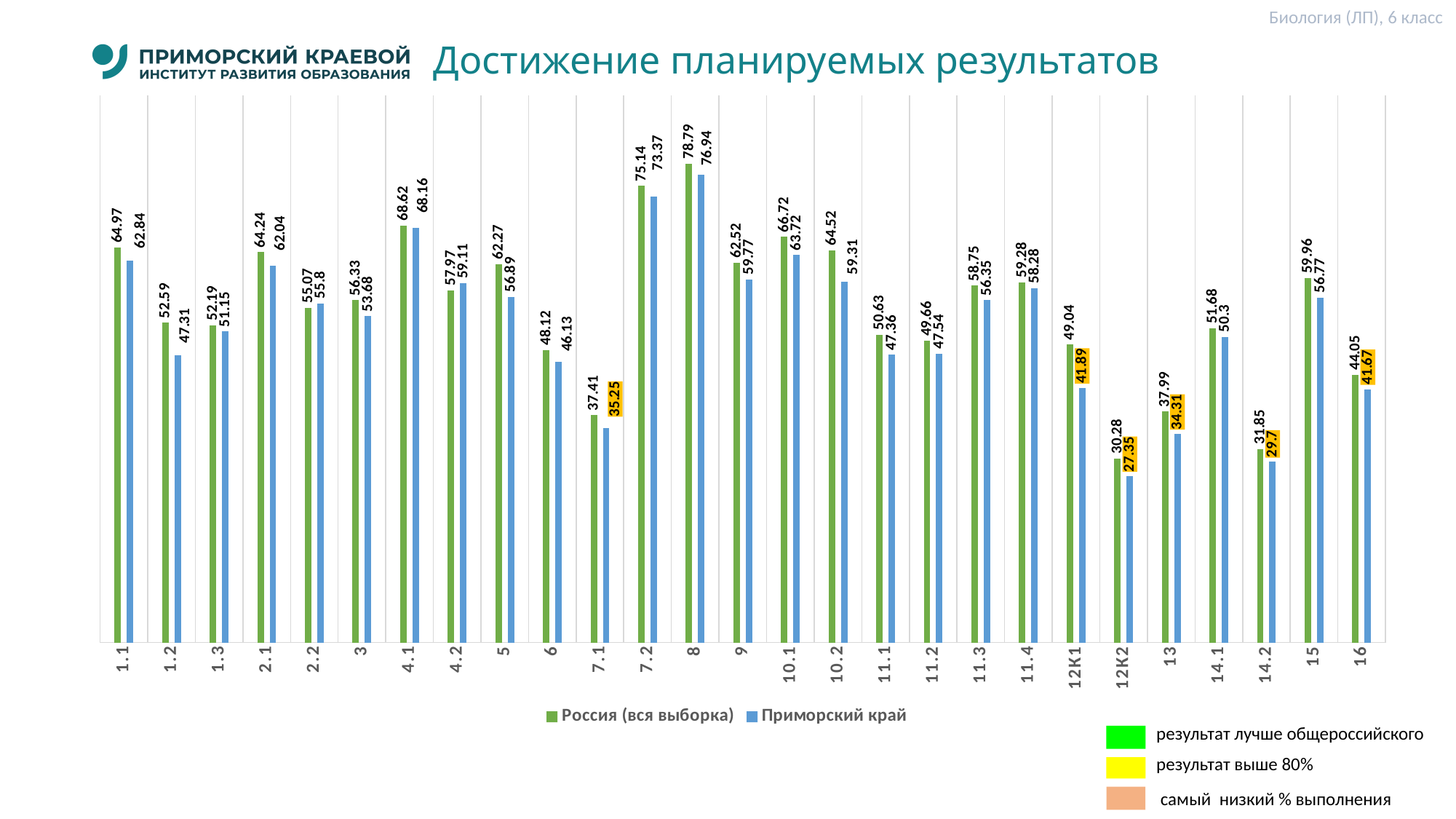
What is the value for Россия (вся выборка) for category 12К2? 30.28 Which category has the lowest value for Россия (вся выборка)? 12К2 How many categories are shown on the x axis of the chart? 27 What is the difference between the Россия (вся выборка) and Приморский край values for category 1.2? 5.28 Which category has the highest value for Приморский край? 8 What is the value for Приморский край for category 7.1? 35.25 What is the title of the chart on the slide? Достижение планируемых результатов What type of chart is shown on the slide? Bar chart How many series does the chart legend list? 2 For category 2.2, which series has the larger value: Россия (вся выборка) or Приморский край? Приморский край What is the difference between the Россия (вся выборка) and Приморский край values for category 12К1? 7.15 What is the value for Приморский край for category 8? 76.94